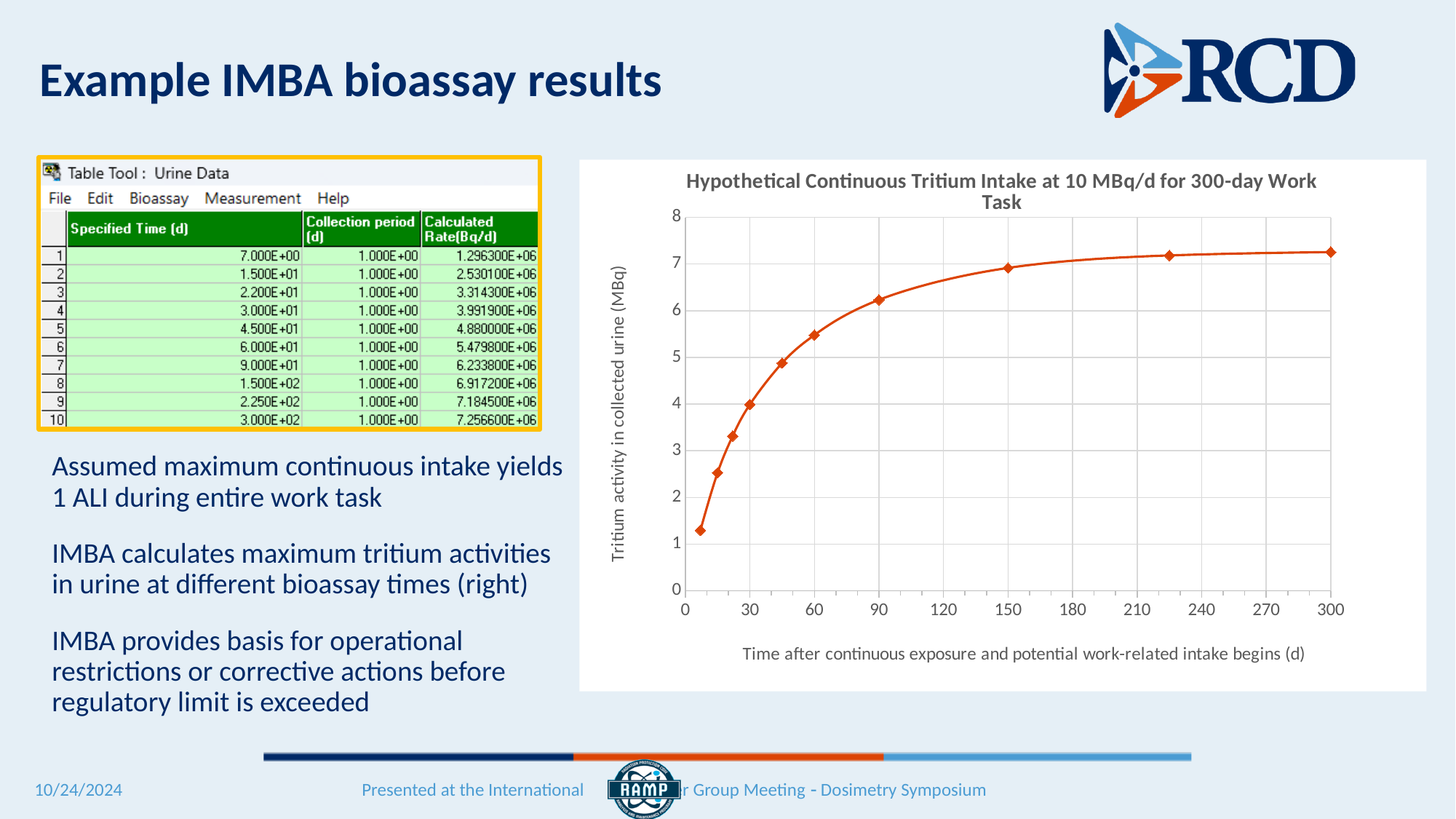
Is the value at 150 days greater or less than 6? greater Is the value at 90 days greater or less than 6? greater What is the title of the chart? Hypothetical Continuous Tritium Intake at 10 MBq/d for 300-day Work Task How many data points are plotted on the chart? 10 At what time on the x axis does the highest plotted point occur? 300 Do the plotted values rise or fall as time increases along the x axis? rise Is the value at 60 days greater or less than 6? less Which is larger, the value at 60 days or the value at 90 days? 90 days What is the label of the y axis of the chart? Tritium activity in collected urine (MBq) What kind of chart is shown on the slide? line chart